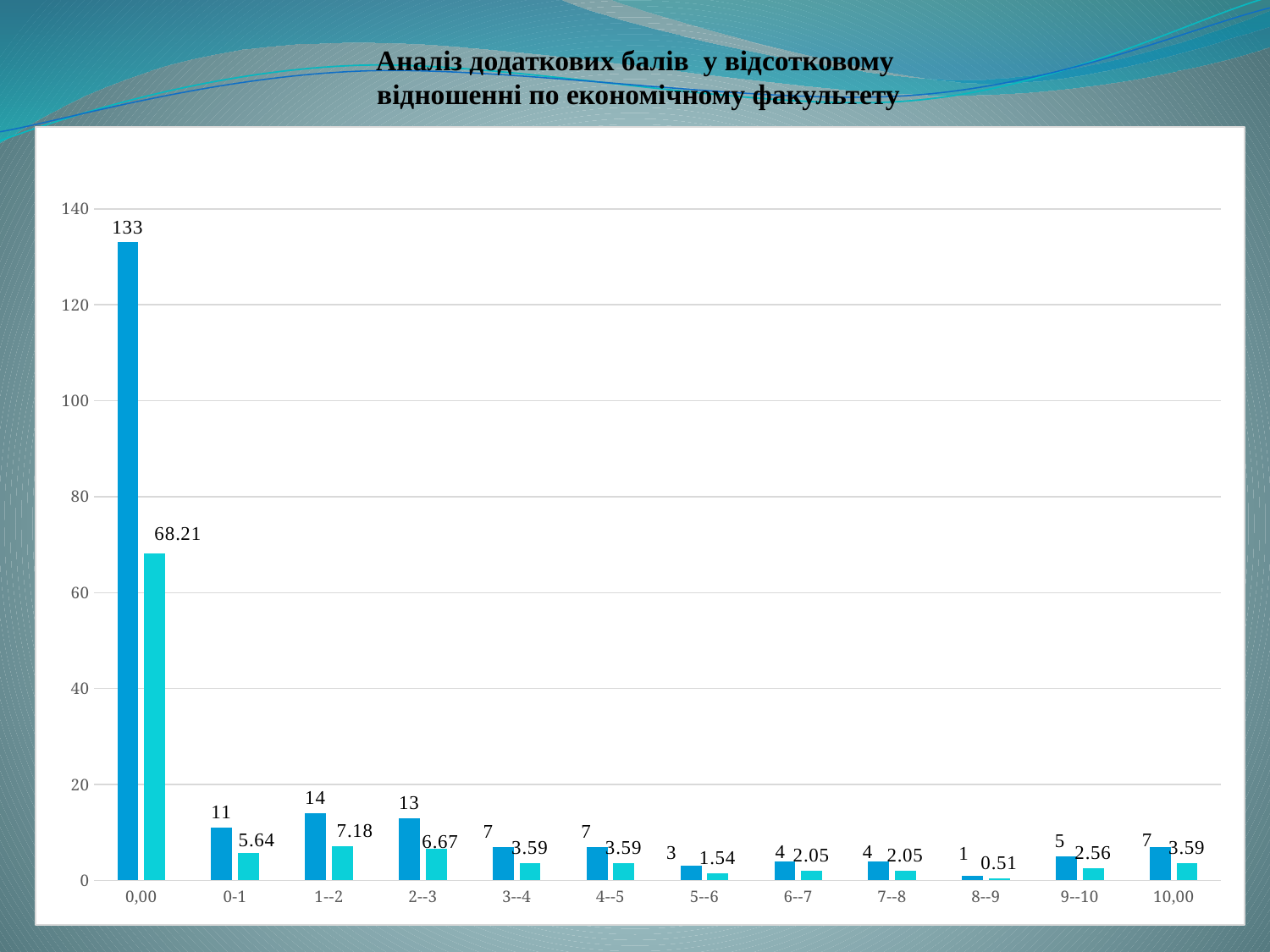
Which is larger, the dark blue bar for 0-1 or the dark blue bar for 5--6? 0-1 What is the difference between the dark blue bar values for 1--2 and 2--3? 1 What is the value of the light cyan bar for the category 0,00? 68.21 What is the value of the dark blue bar for the category 1--2? 14 Which category has the highest dark blue bar? 0,00 Which category has the lowest dark blue bar? 8--9 What is the value of the dark blue bar for the category 0,00? 133 How many categories are shown on the x axis of the chart? 12 What is the title of the chart on the slide? Аналіз додаткових балів у відсотковому відношенні по економічному факультету What is the value of the light cyan bar for the category 9--10? 2.56 What type of chart is shown on the slide? bar chart Is the dark blue bar for the category 0,00 greater or less than 120? greater